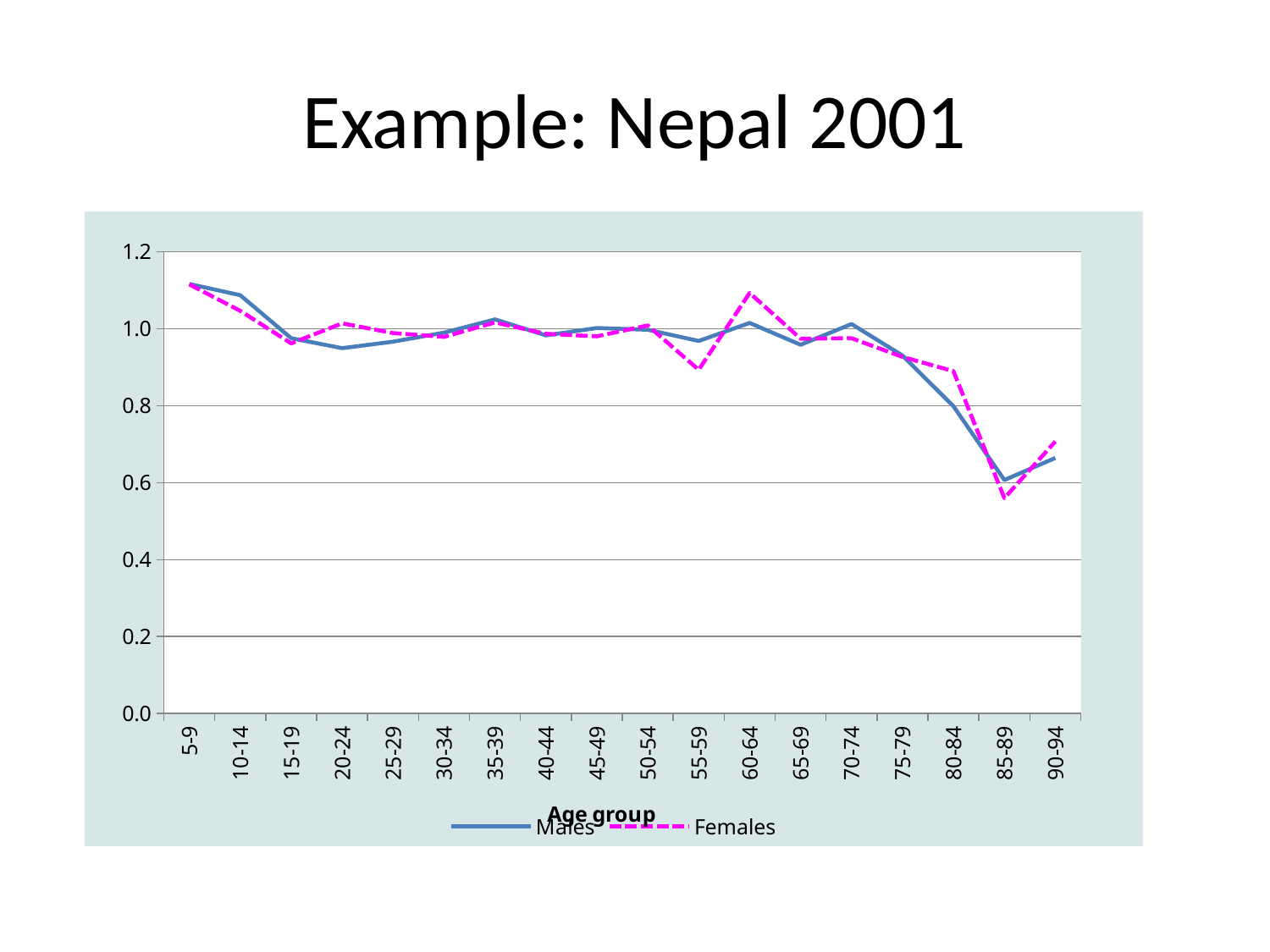
Is the value for Males at 85-89 greater or less than 0.8? less What is the title of the x axis? Age group At age group 60-64, which series has the larger value, Males or Females? Females Is the value for Males at 5-9 greater or less than 1.0? greater How many age groups are plotted along the x axis? 18 At age group 55-59, which series has the larger value, Males or Females? Males Which age group has the lowest value for Females? 85-89 What kind of chart is shown on the slide? Line chart How many series does the legend list? 2 Which age group has the highest value for Males? 5-9 Which age group has the lowest value for Males? 85-89 Is the value for Females at 55-59 greater or less than 1.0? less